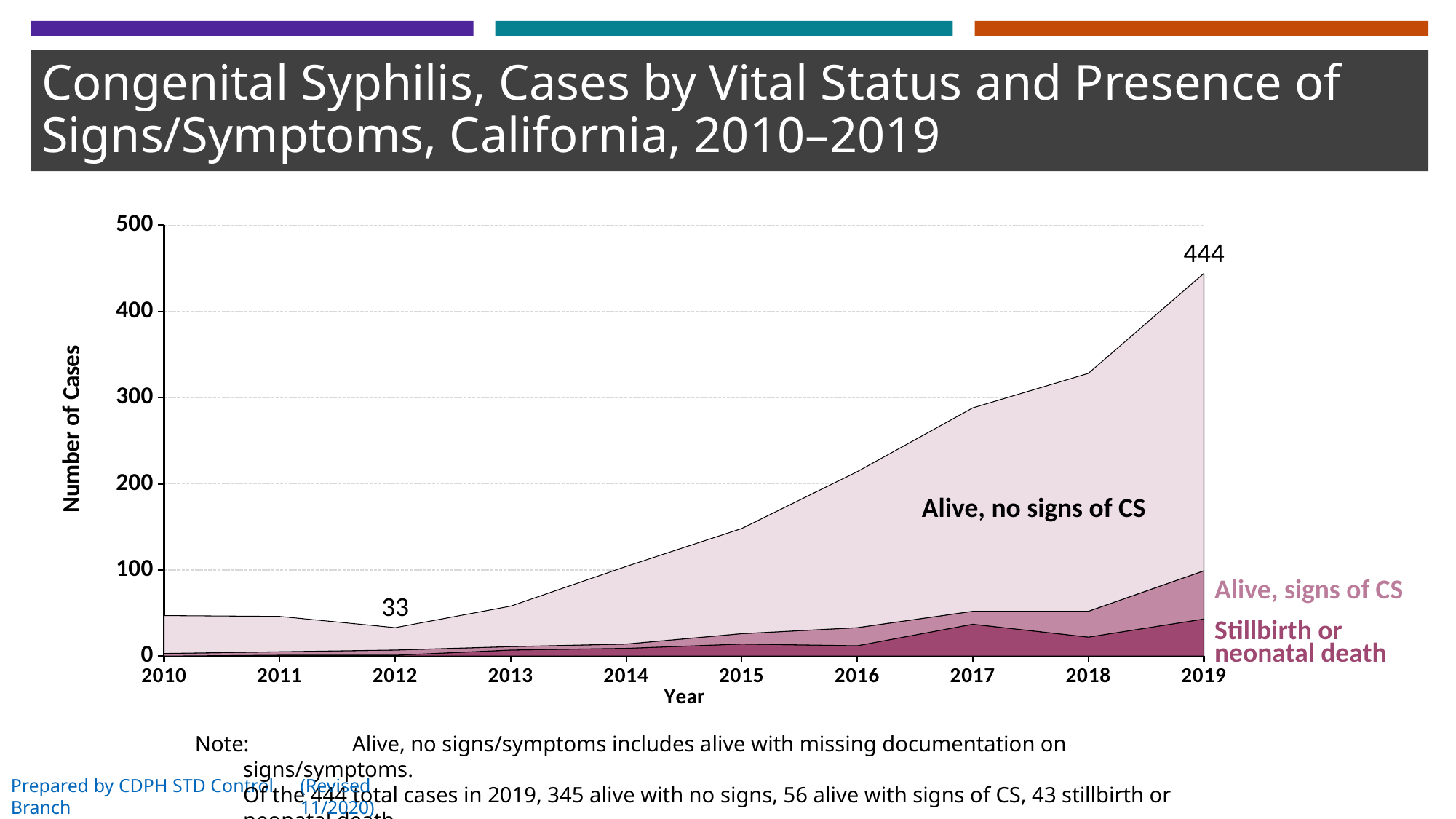
What is the overall trend in total cases from 2012 to 2019? Rising Which year has the lowest total number of cases? 2012 In 2019, how many more cases were alive with no signs of CS than alive with signs of CS? 289 Of the 444 cases in 2019, how many were alive with no signs of CS? 345 What type of chart is shown on the slide? Area chart How many years are shown on the x axis? 10 What was the total number of congenital syphilis cases in California in 2019? 444 Which year has the highest total number of cases? 2019 What was the total number of congenital syphilis cases in 2012? 33 Is the total number of cases in 2017 greater or less than 200? greater Of the 444 cases in 2019, how many were stillbirth or neonatal death? 43 What is the difference between the total cases in 2019 and in 2012? 411